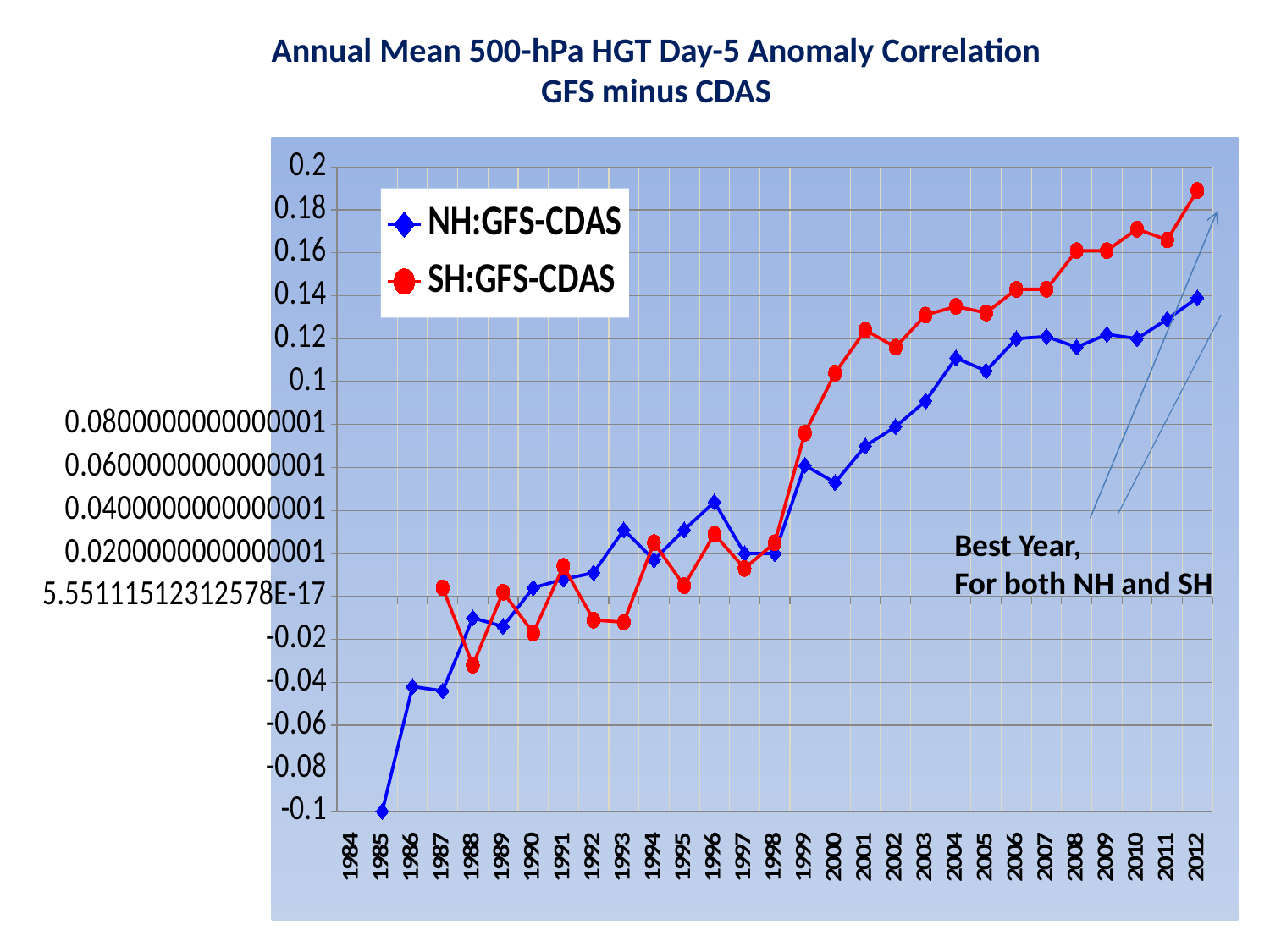
What are the two series named in the legend? NH:GFS-CDAS and SH:GFS-CDAS Overall, does the NH:GFS-CDAS series rise or fall from 1985 to 2012? rise In which year does the SH:GFS-CDAS series reach its highest value? 2012 Is the value for SH:GFS-CDAS in 2012 greater or less than 0.18? greater How many series does the legend list? 2 In 2012, which series has the larger value, NH:GFS-CDAS or SH:GFS-CDAS? SH:GFS-CDAS Is the value for SH:GFS-CDAS in 2008 greater or less than 0.14? greater What is the title of the chart? Annual Mean 500-hPa HGT Day-5 Anomaly Correlation GFS minus CDAS Is the value for NH:GFS-CDAS in 1985 greater or less than -0.08? less In 1993, which series has the larger value, NH:GFS-CDAS or SH:GFS-CDAS? NH:GFS-CDAS What kind of chart is shown on the slide? line chart